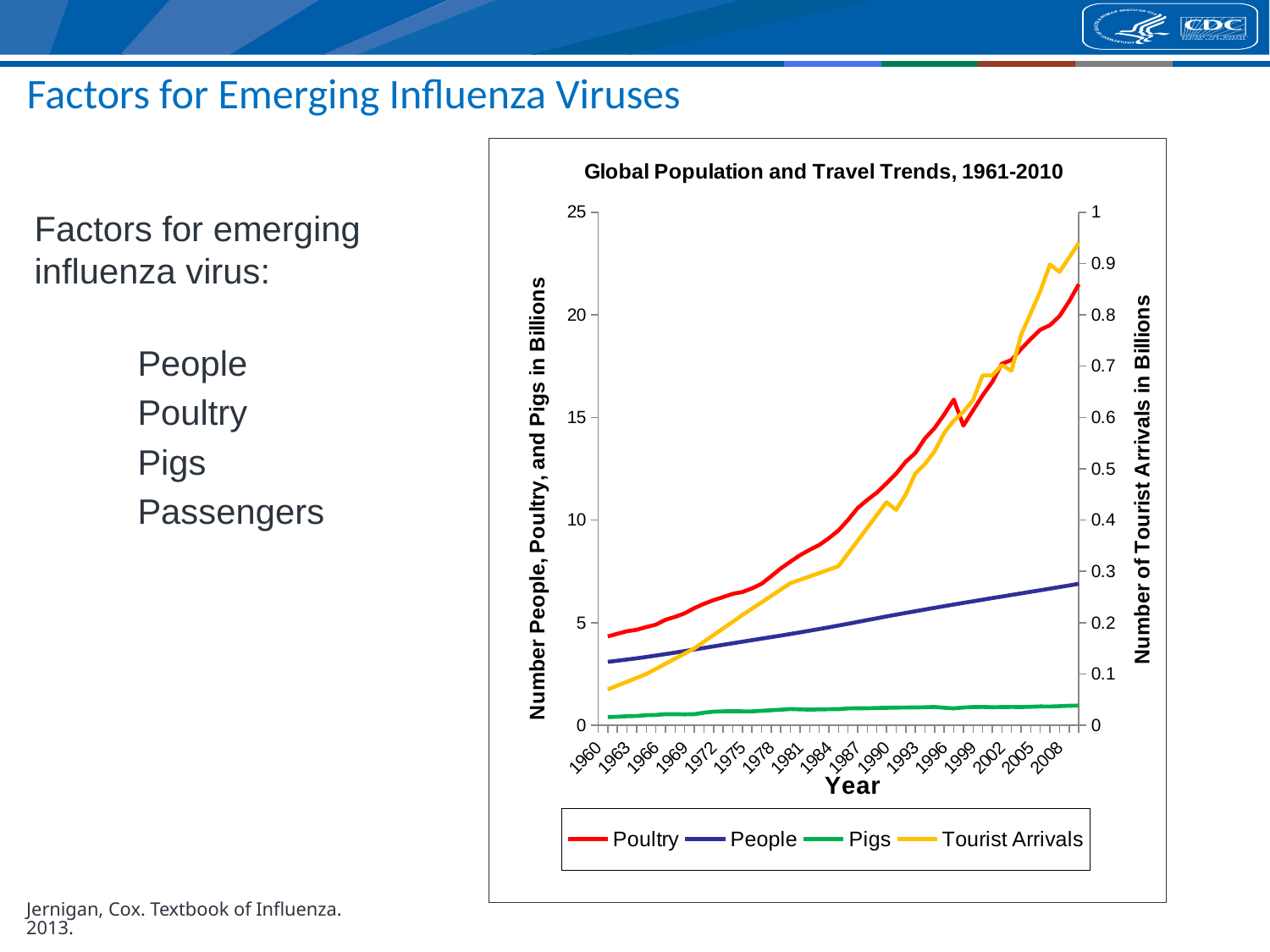
Is the value for Pigs in 2008 greater or less than 5 on the left axis? less Does the People line rise or fall across the years shown? Rises How many series does the chart's legend list? 4 Is the value for People in 2008 greater or less than 10 on the left axis? less Among Poultry, People and Pigs, which series has the lowest value in 2008? Pigs What is the label of the right-hand vertical axis? Number of Tourist Arrivals in Billions Does the Poultry line rise or fall from 1960 to 2008? Rises Is the value for Tourist Arrivals in 2008 greater or less than 0.8 on the right axis? greater In 2008, which is larger on the left axis: Poultry or People? Poultry What kind of chart is shown on the slide? Line chart What is the title of the chart? Global Population and Travel Trends, 1961-2010